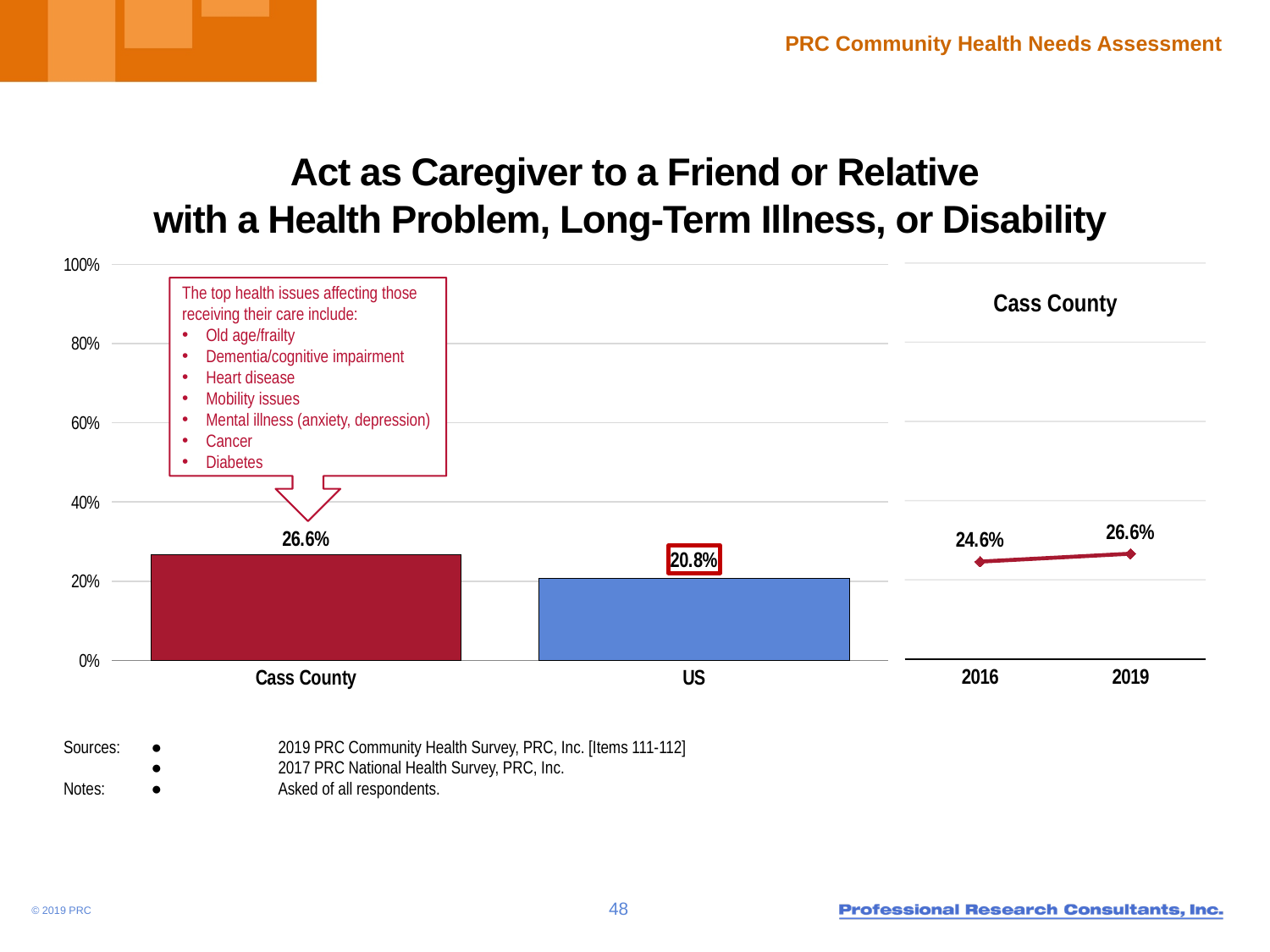
In the bar chart on the left, is the value for US greater or less than 40%? less In the Cass County trend chart on the right, did the value rise or fall from 2016 to 2019? Rise In the bar chart on the left, what is the value for Cass County? 26.6% In the bar chart on the left, what is the value for US? 20.8% In the Cass County trend chart on the right, what is the value for 2019? 26.6% What kind of chart is the chart on the left? Bar chart In the Cass County trend chart on the right, what is the value for 2016? 24.6% In the bar chart on the left, which category has the higher value, Cass County or US? Cass County In the Cass County trend chart on the right, what is the difference between the 2019 and 2016 values? 2 percentage points In the bar chart on the left, how many categories are shown? 2 In the bar chart on the left, what is the difference between the Cass County value and the US value? 5.8 percentage points What is the title of the slide's chart? Act as Caregiver to a Friend or Relative with a Health Problem, Long-Term Illness, or Disability